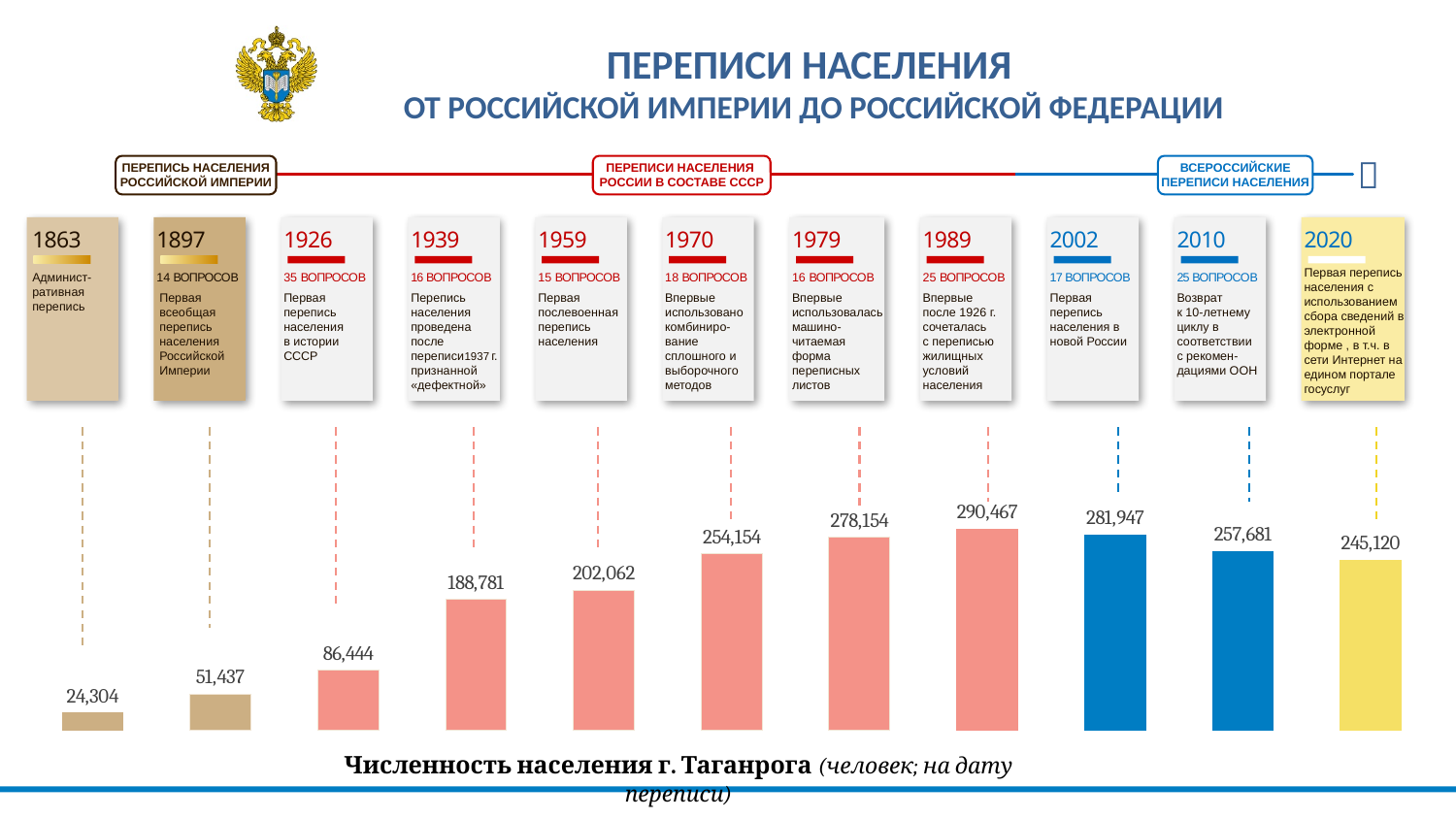
Which census year has the highest population value in the chart? 1989 What is the population of Taganrog shown for the 1897 census? 51,437 What is the title of the chart at the bottom of the slide? Численность населения г. Таганрога (человек; на дату переписи) How many census years are plotted as bars in the chart? 11 What type of chart is used to show the population of Taganrog? Bar chart What is the difference between the population values for 1926 and 1897? 35,007 What value is shown for the 1939 census in the Taganrog population chart? 188,781 Which census year has the lowest population value in the chart? 1863 Do the population values rise or fall from 1863 to 1989? Rise Which is larger, the population value for 2002 or for 2010? 2002 What is the population value shown for 2020? 245,120 What is the difference between the population values for 1989 and 2020? 45,347